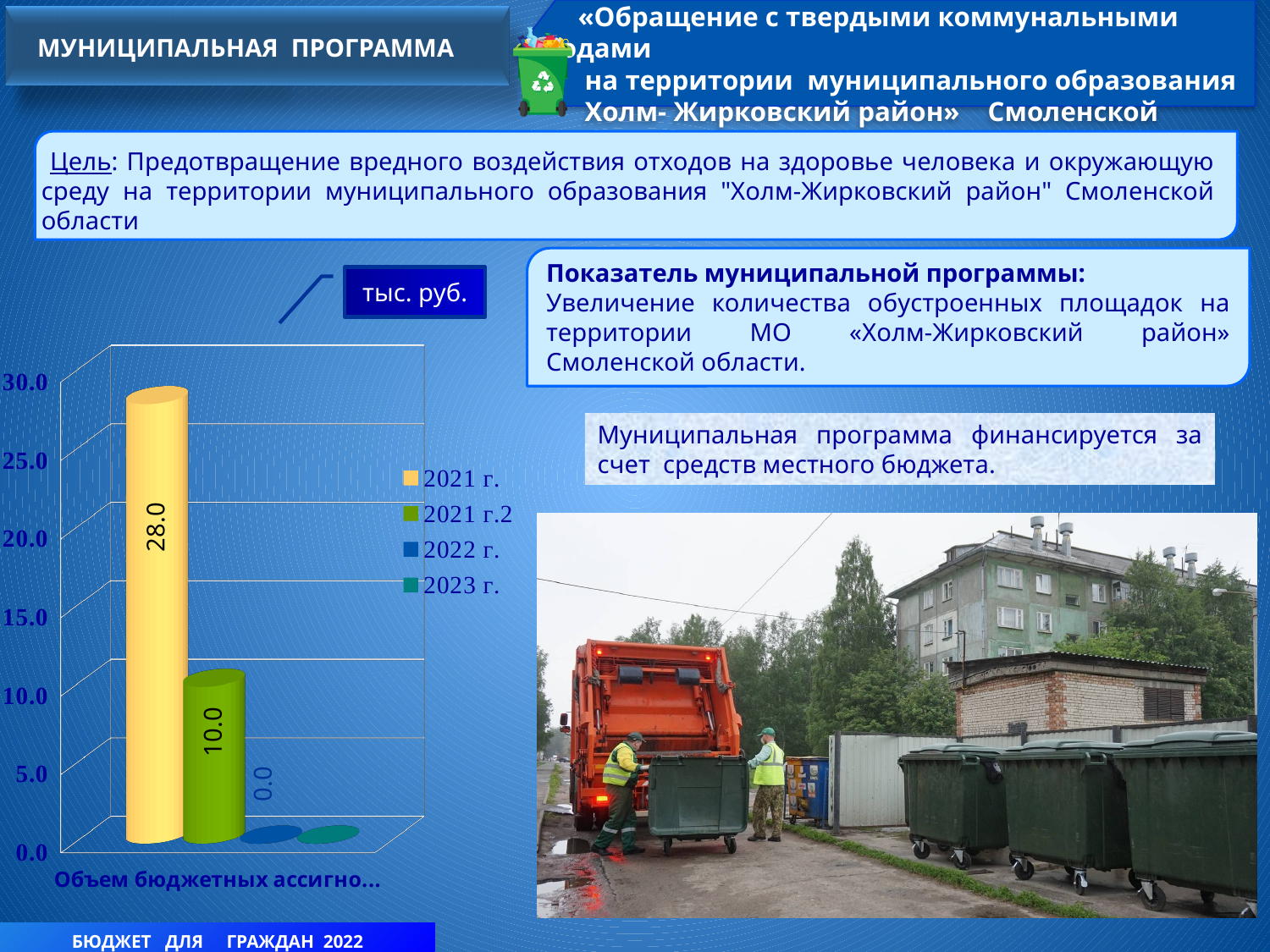
What is the value for the series "2021 г." in the chart? 28.0 Is the value for "2021 г." greater or less than 25.0? greater What is the difference between the values for "2021 г." and "2021 г.2"? 18.0 How many series does the chart legend list? 4 What unit of measurement is indicated for the chart values? тыс. руб. What kind of chart is shown on the slide? bar chart Which is larger, the value for "2021 г." or the value for "2021 г.2"? 2021 г. Which series has the highest value in the chart? 2021 г. Is the value for "2021 г.2" greater or less than 15.0? less What is the value for the series "2022 г." in the chart? 0.0 What is the value for the series "2021 г.2" in the chart? 10.0 What is the highest value shown on the chart's vertical axis? 30.0